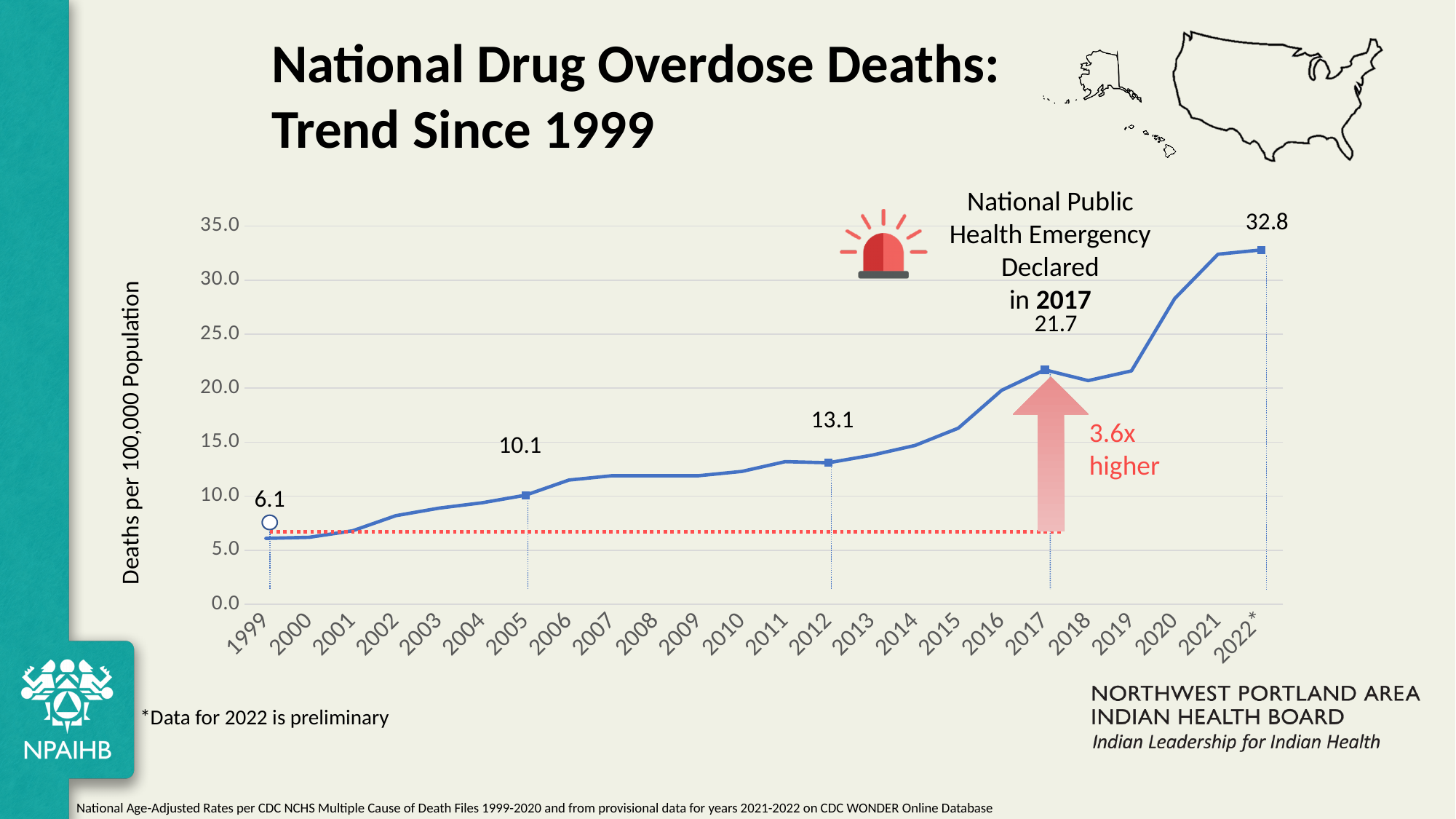
What is the difference between the values for 2017 and 1999? 15.6 What is the value for 2022? 32.8 What is the label of the y axis? Deaths per 100,000 Population Is the value for 2020 greater or less than 25.0? greater What is the value for 2012? 13.1 What is the value for 1999? 6.1 What is the difference between the values for 2022 and 2017? 11.1 What kind of chart is shown on the slide? line chart What is the value for 2005? 10.1 Which year has the highest value on the chart? 2022 What is the value for 2017? 21.7 Which is larger, the value for 2012 or the value for 2005? 2012